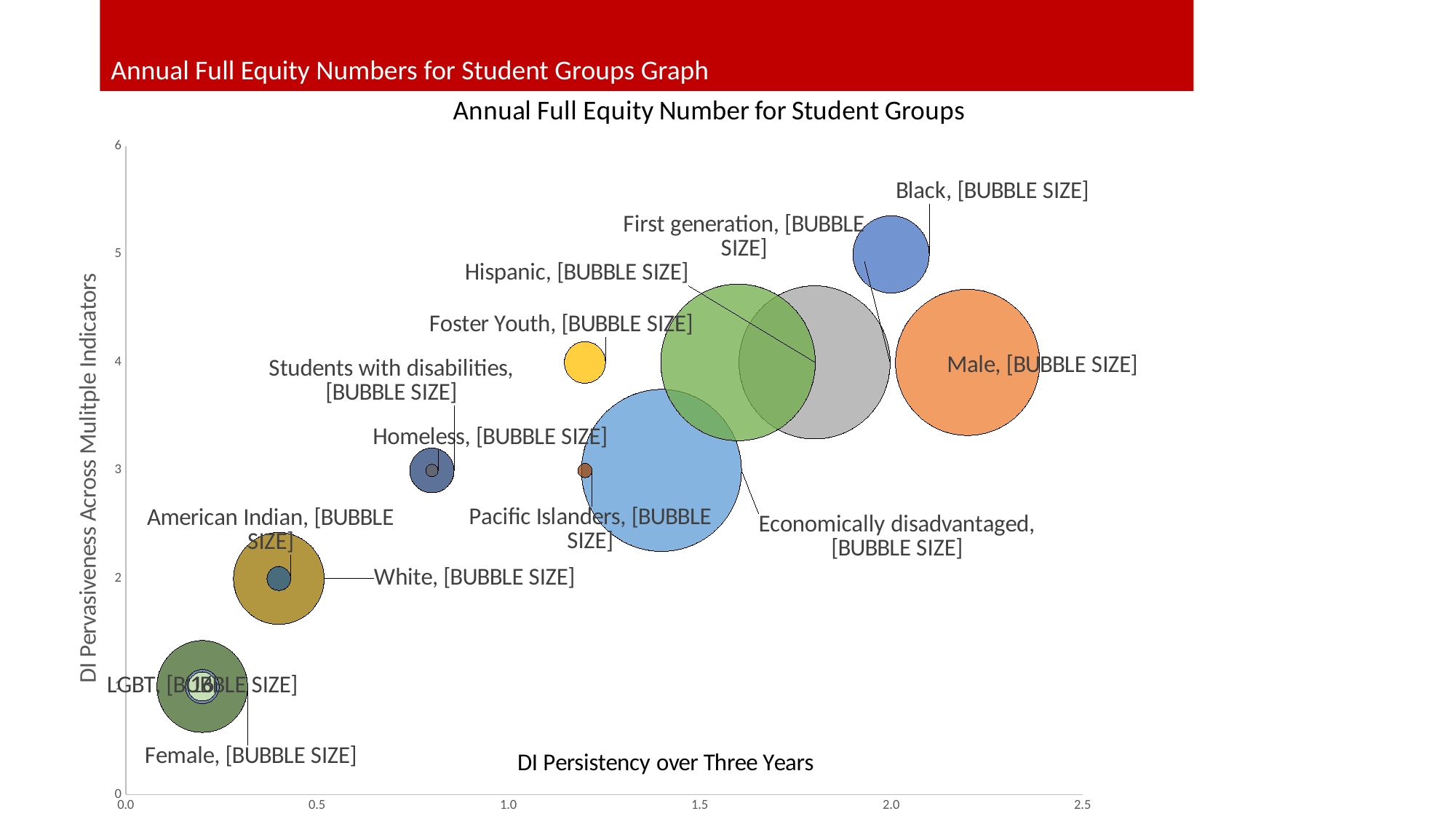
What is the DI Pervasiveness Across Multiple Indicators value for Black? 5 What is the DI Pervasiveness Across Multiple Indicators value for White? 2 What kind of chart is shown on the slide? Bubble chart What is the DI Pervasiveness Across Multiple Indicators value for Male? 4 What is the DI Pervasiveness Across Multiple Indicators value for Foster Youth? 4 What is the title of the chart? Annual Full Equity Number for Student Groups Which student group has the highest DI Pervasiveness Across Multiple Indicators value? Black How many student groups are plotted on the chart? 14 What is the DI Pervasiveness Across Multiple Indicators value for Homeless? 3 Is the DI Persistency over Three Years value for Male greater or less than 2.0? greater Is the DI Persistency over Three Years value for Homeless greater or less than 1.0? less What is the label of the horizontal axis? DI Persistency over Three Years